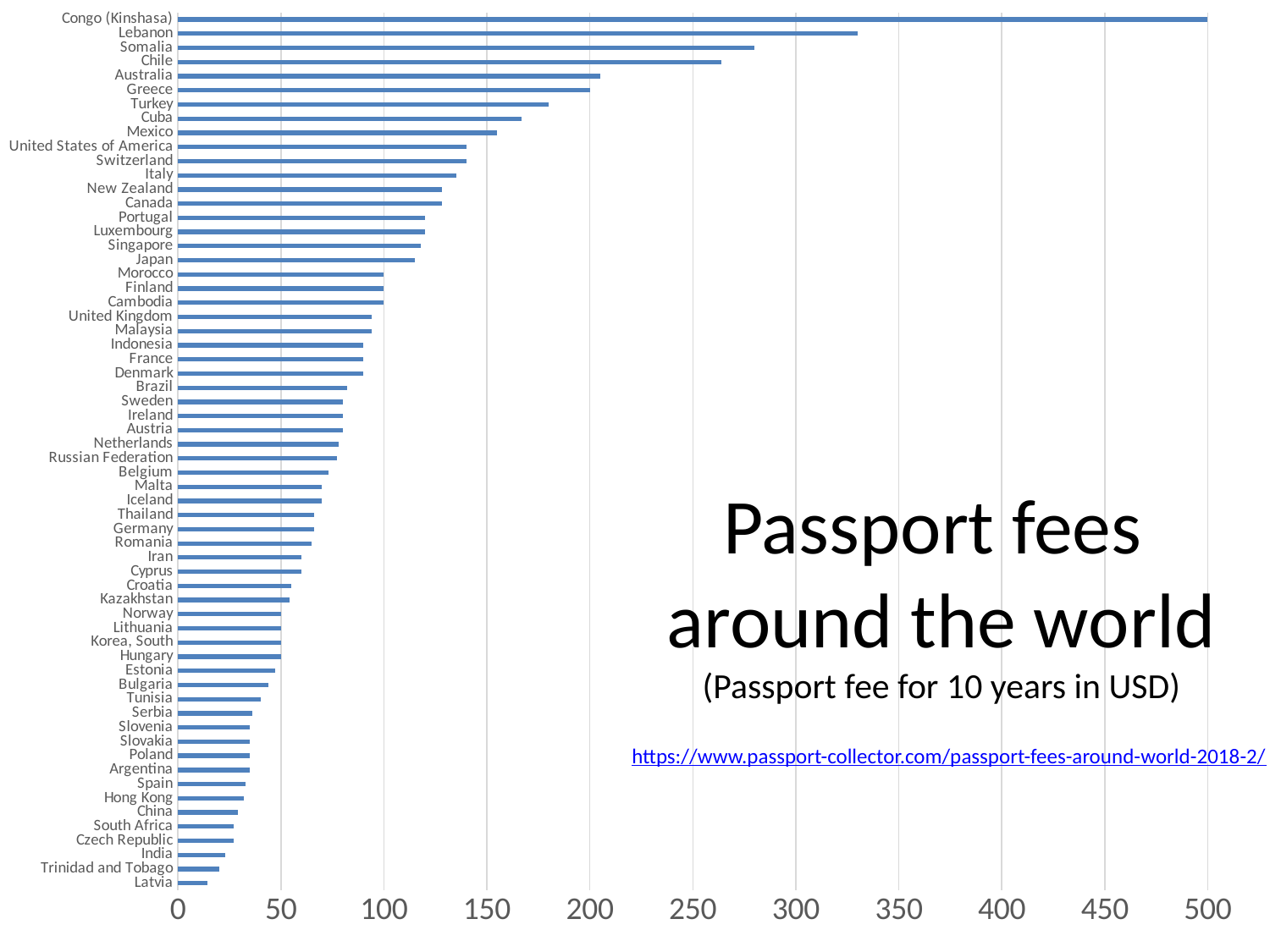
Is the value for United States of America greater or less than 150? less Which country has the lowest passport fee in the chart? Latvia Is the value for India greater or less than 50? less What is the title of the chart on the slide? Passport fees around the world Which has the larger passport fee, Chile or Australia? Chile Is the value for Lebanon greater or less than 300? greater Which country has the highest passport fee in the chart? Congo (Kinshasa) What is the passport fee for Congo (Kinshasa) according to the chart? 500 Which has the larger passport fee, Lebanon or Somalia? Lebanon What kind of chart is shown on the slide? bar chart